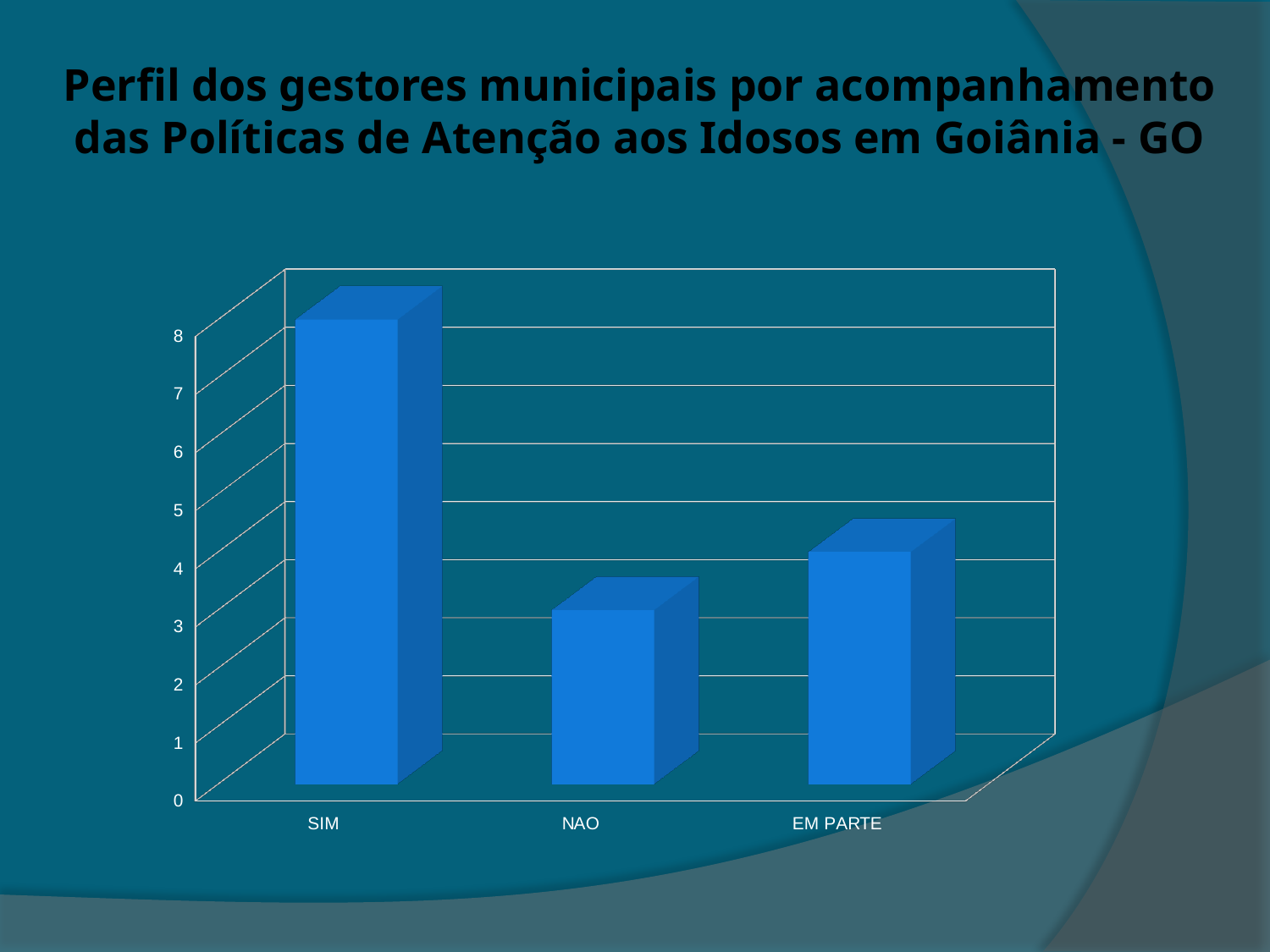
How many categories are shown on the x axis of the chart? 3 Which is larger, the value for EM PARTE or the value for NAO? EM PARTE Which is larger, the value for SIM or the value for NAO? SIM Is the value for NAO greater or less than 2? greater What is the title of the slide containing the chart? Perfil dos gestores municipais por acompanhamento das Políticas de Atenção aos Idosos em Goiânia - GO Is the value for SIM greater or less than 7? greater Is the value for NAO greater or less than 5? less What kind of chart is shown on the slide? bar chart Which category has the lowest bar? NAO What colour are the bars in the chart? blue Which category has the highest bar? SIM